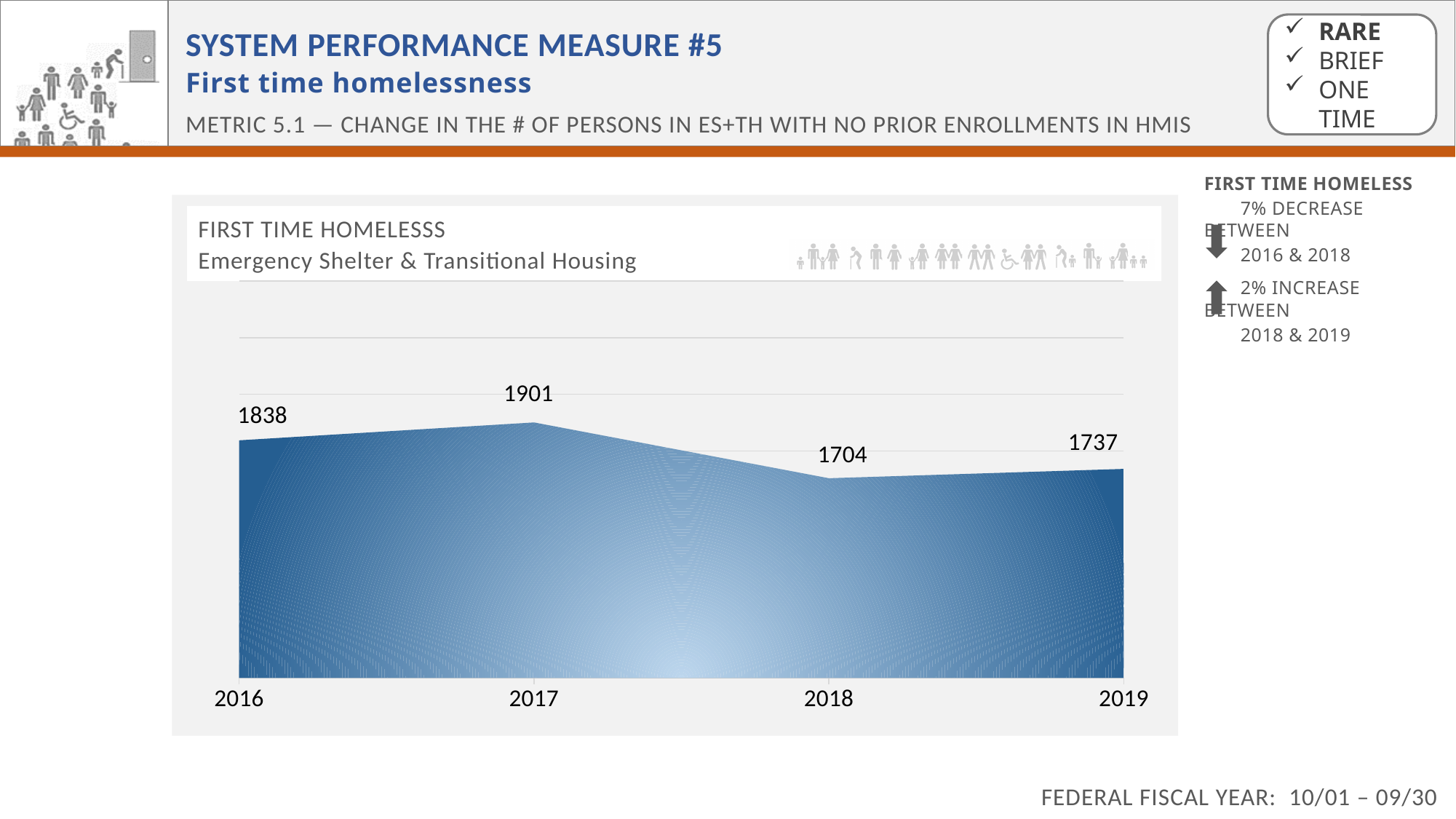
Which year has the lowest value? 2018 What is the difference between the values for 2017 and 2018? 197 What is the difference between the values for 2019 and 2018? 33 What is the value for 2016? 1838 Does the value rise or fall from 2017 to 2018? Fall Which year has the highest value? 2017 Which is larger, the value for 2016 or the value for 2019? 2016 What is the value for 2019? 1737 How many years are plotted on the chart? 4 What kind of chart is shown? Area chart What is the value for 2018? 1704 What is the value for 2017? 1901